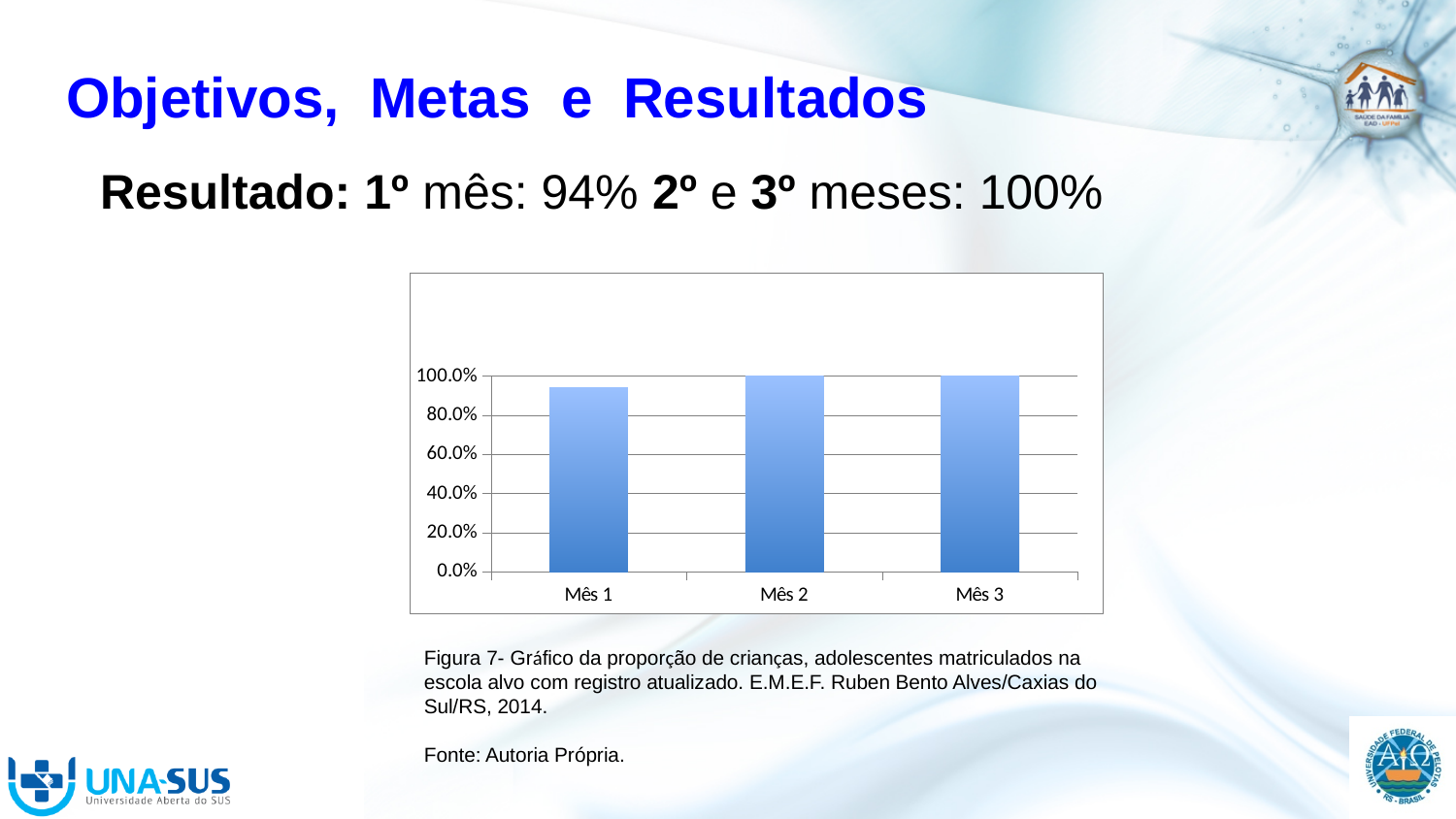
What is the value for Mês 2 in the chart? 100.0% Do the values rise or fall from Mês 1 to Mês 3? rise What is the label of the first category on the x axis? Mês 1 What colour are the bars in the chart? blue What kind of chart is shown on the slide? bar chart Which is larger, the value for Mês 1 or the value for Mês 2? Mês 2 Is the value for Mês 1 greater or less than 80.0%? greater What is the value for Mês 3 in the chart? 100.0% Is the value for Mês 1 greater or less than 100.0%? less How many categories are shown on the x axis of the chart? 3 Which category has the lowest value in the chart? Mês 1